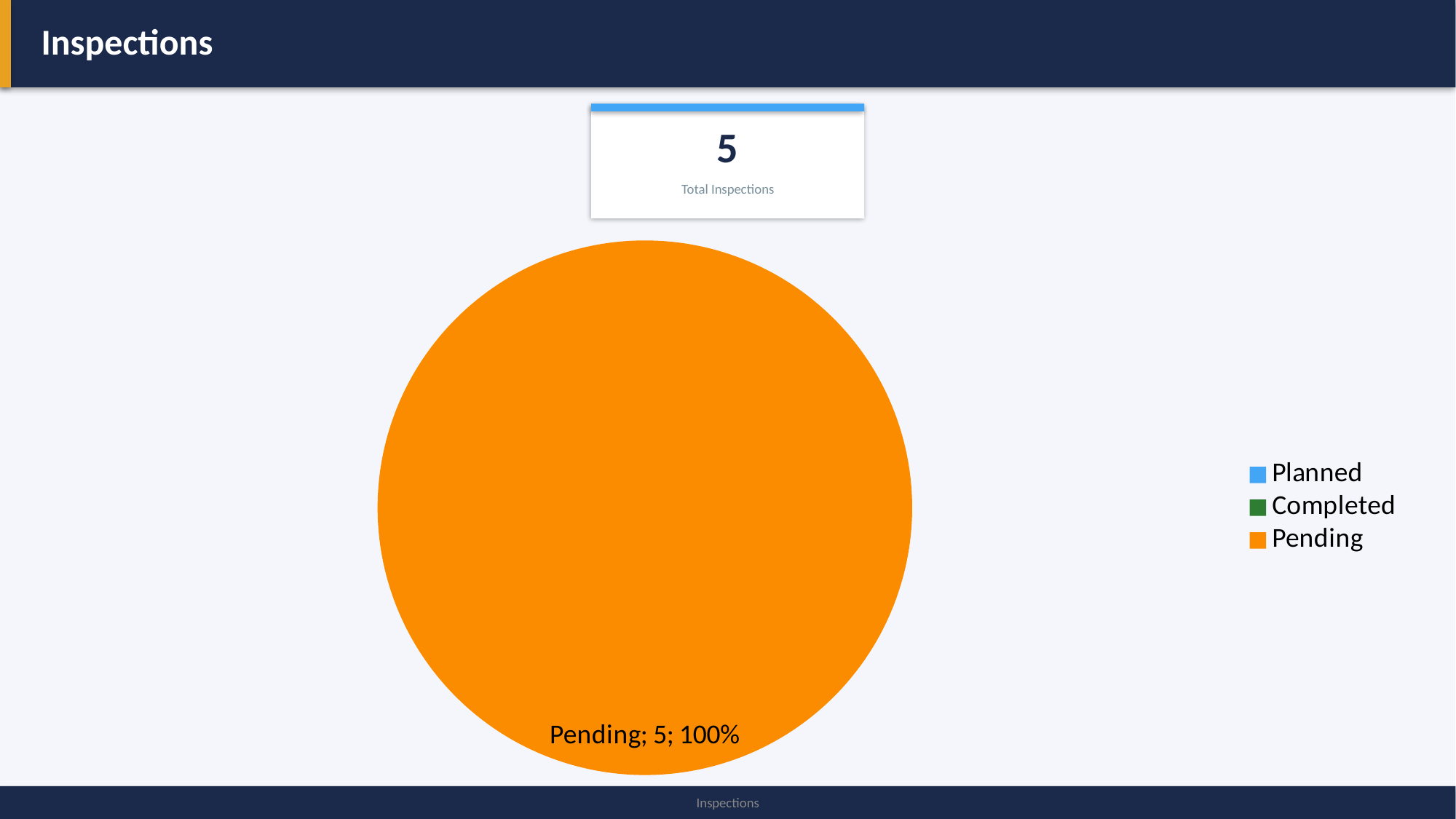
What is the value shown for the Pending slice of the pie chart? 5 Is the value for Pending greater or less than 3? greater What is the Total Inspections figure shown above the pie chart? 5 What kind of chart is shown on the slide? pie chart How many entries does the pie chart's legend list? 3 What share of the pie does the Pending slice represent? 100% What colour is the Pending slice in the pie chart? orange Which category has the largest slice in the pie chart? Pending Which legend entry is shown in green? Completed